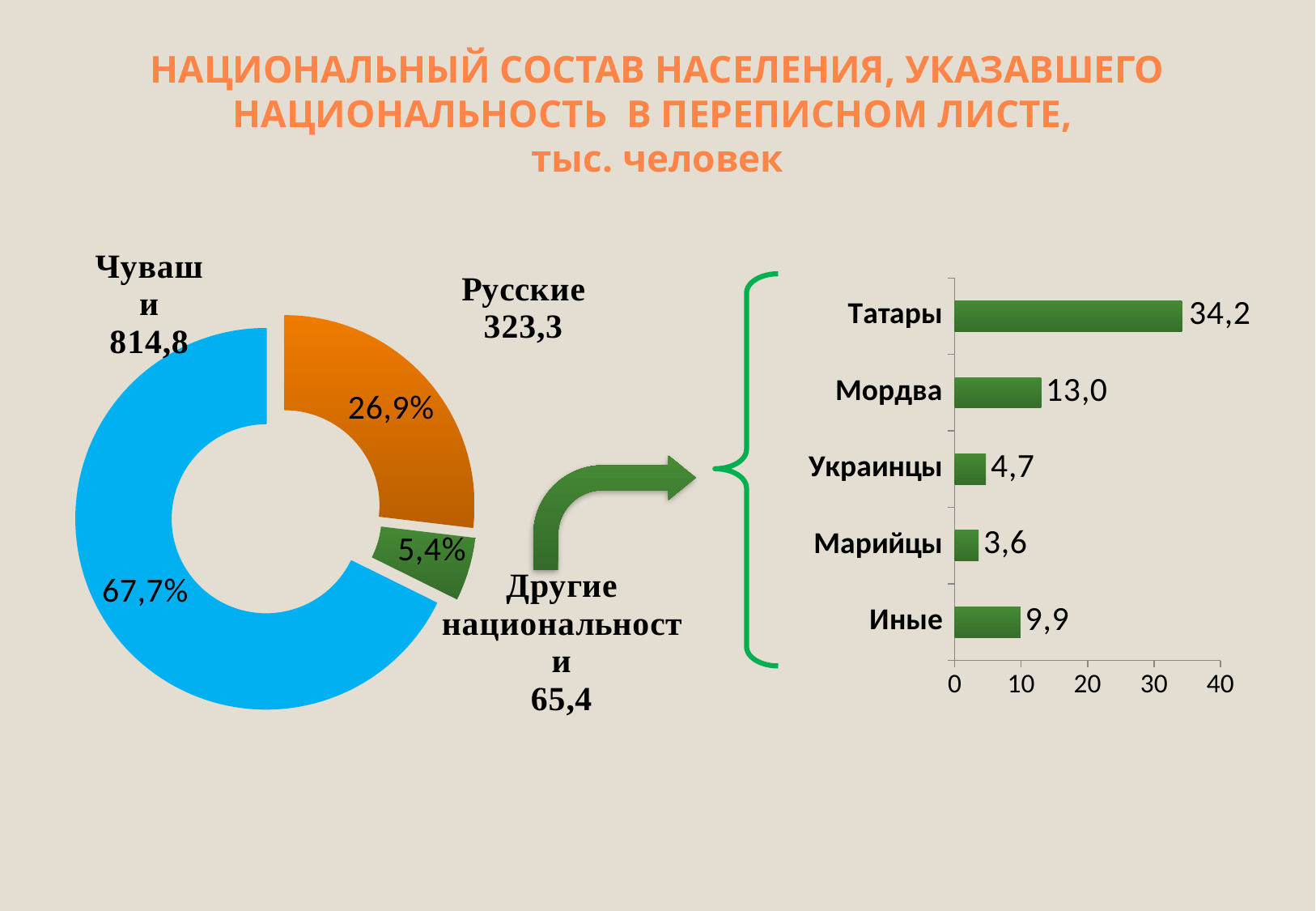
In the donut chart on the left, what percentage share is shown for Русские? 26,9% In the donut chart on the left, which category has the largest share? Чуваши In the donut chart on the left, what is the difference between the values for Чуваши and Русские? 491,5 In the bar chart on the right, what is the difference between the values for Татары and Мордва? 21,2 In the bar chart on the right, which is larger: Мордва or Иные? Мордва In the donut chart on the left, what value is shown for Чуваши? 814,8 In the bar chart on the right, which category has the lowest value? Марийцы In the bar chart on the right, what is the value for Марийцы? 3,6 What type of chart is shown on the right side of the slide? Bar chart How many categories are shown in the bar chart on the right? 5 In the bar chart on the right, what is the value for Татары? 34,2 In the donut chart on the left, what value is shown for Другие национальности? 65,4